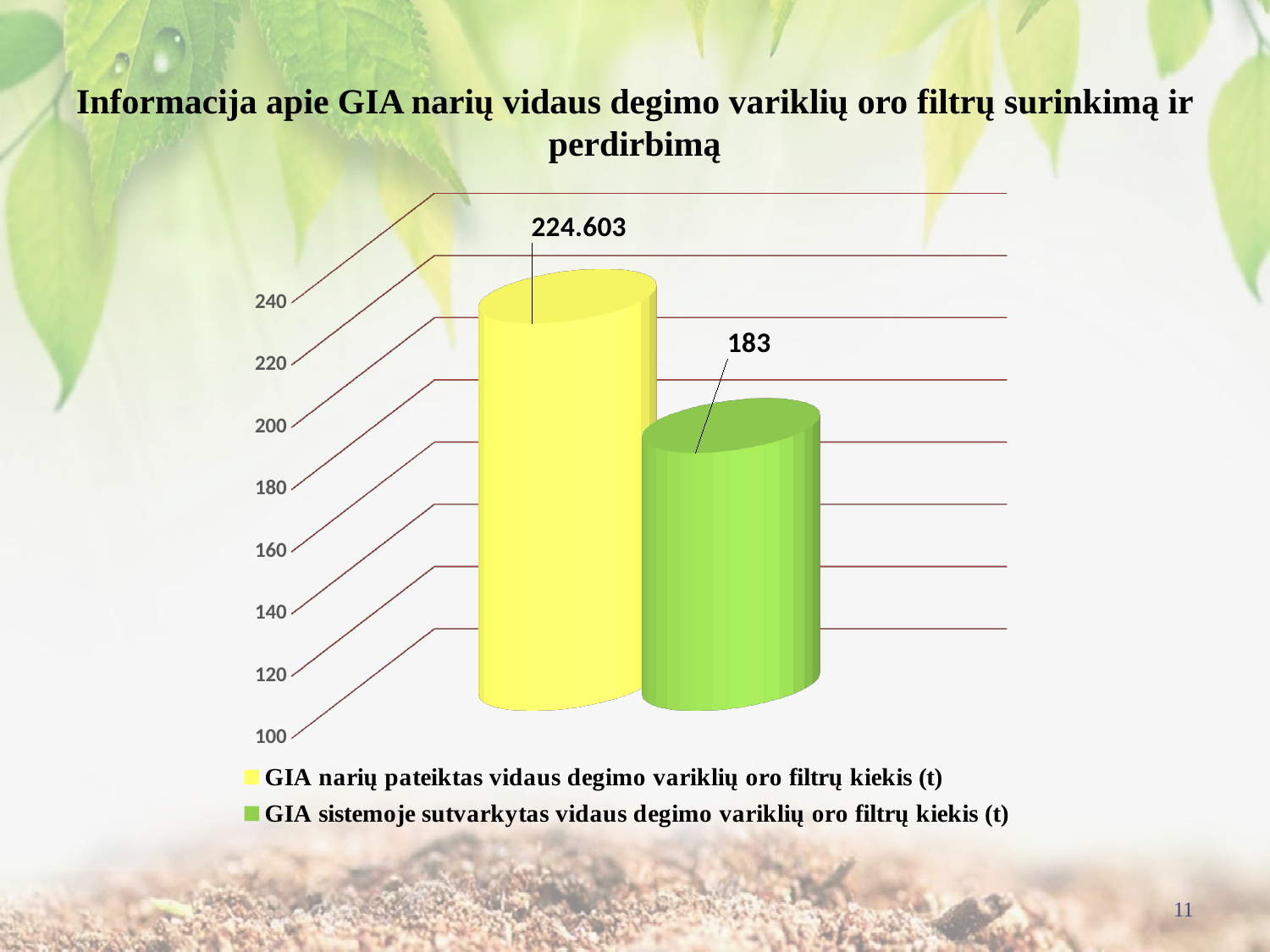
What value is shown for 'GIA narių pateiktas vidaus degimo variklių oro filtrų kiekis (t)'? 224.603 Which series has the higher value? GIA narių pateiktas vidaus degimo variklių oro filtrų kiekis (t) What is the difference between the quantity submitted by GIA members (224.603) and the quantity processed in the GIA system (183)? 41.603 What kind of chart is shown on the slide? bar chart Is the value for the yellow bar larger or smaller than the value for the green bar? larger How many bars are plotted on the chart? 2 Is the value for 'GIA sistemoje sutvarkytas vidaus degimo variklių oro filtrų kiekis (t)' greater or less than 200? less What value is shown for 'GIA sistemoje sutvarkytas vidaus degimo variklių oro filtrų kiekis (t)'? 183 Is the value for 'GIA narių pateiktas vidaus degimo variklių oro filtrų kiekis (t)' greater or less than 220? greater What colour is the bar for 'GIA sistemoje sutvarkytas vidaus degimo variklių oro filtrų kiekis (t)'? green Which series has the lower value? GIA sistemoje sutvarkytas vidaus degimo variklių oro filtrų kiekis (t) How many series does the legend list? 2